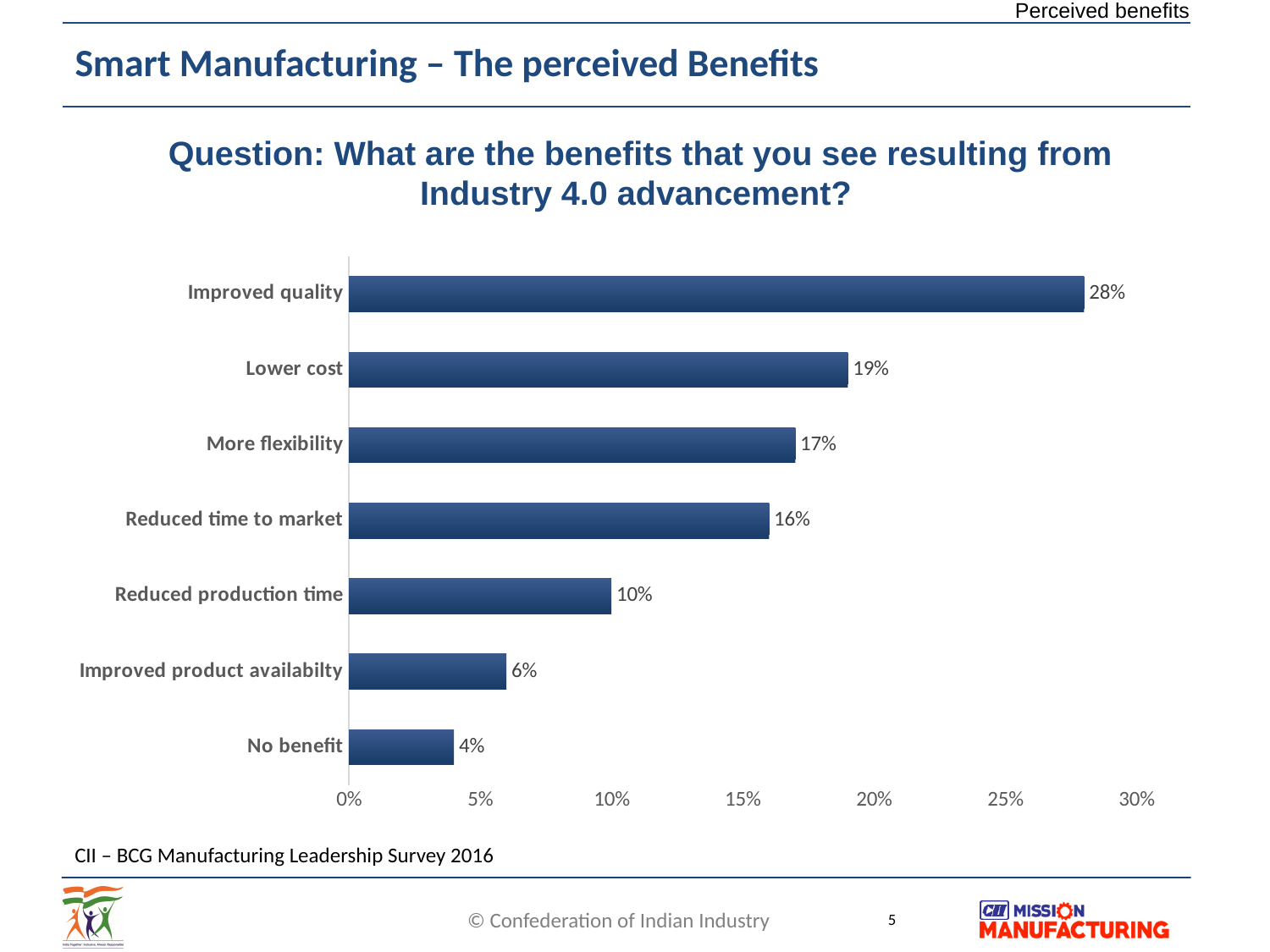
What kind of chart is shown on the slide? Bar chart What is the highest value shown on the horizontal axis? 30% What is the value shown for Reduced time to market? 16% What percentage of respondents cited Improved quality as a benefit? 28% How many categories are shown in the chart? 7 Which is larger, the value for More flexibility or the value for Reduced production time? More flexibility Which benefit has the highest value? Improved quality What is the difference between the values for Reduced production time and Improved product availabilty? 4% What is the value shown for No benefit? 4% Which category has the lowest value? No benefit What is the difference between the values for Improved quality and Lower cost? 9% Is the value for Lower cost greater or less than 15%? greater